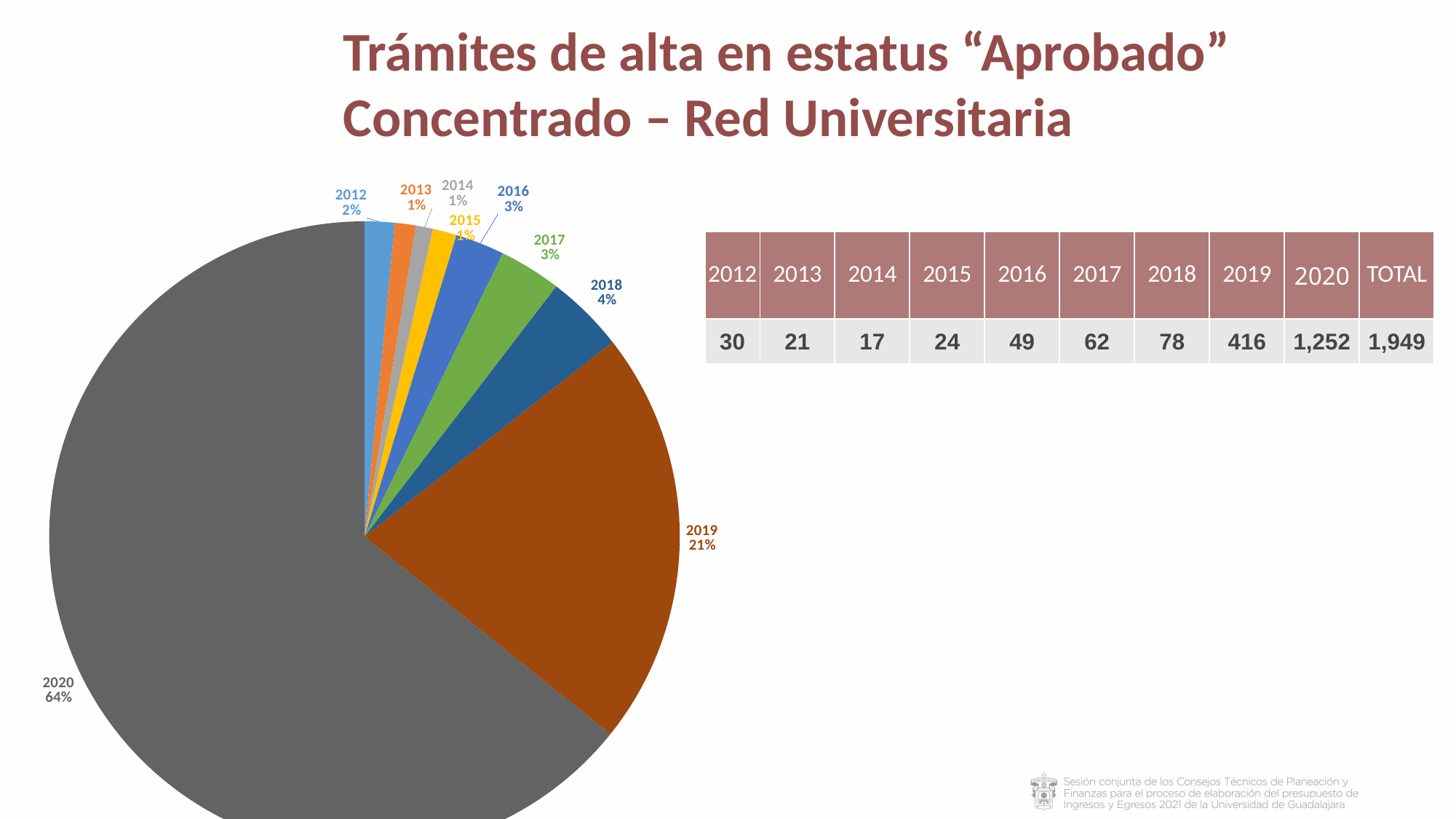
Which slice is larger, 2019 or 2018? 2019 What kind of chart is shown on the slide? pie chart What share of the pie does the 2020 slice represent? 64% What is the title of the slide containing the pie chart? Trámites de alta en estatus "Aprobado" Concentrado – Red Universitaria What percentage is shown for the 2018 slice? 4% What share of the pie does the 2019 slice represent? 21% What colour is the 2019 slice of the pie chart? brown What is the difference in percentage points between the 2020 slice and the 2019 slice? 43 What percentage is shown for the 2012 slice? 2% Which year has the largest slice of the pie? 2020 What percentage is shown for the 2017 slice? 3% How many slices (years) does the pie chart have? 9